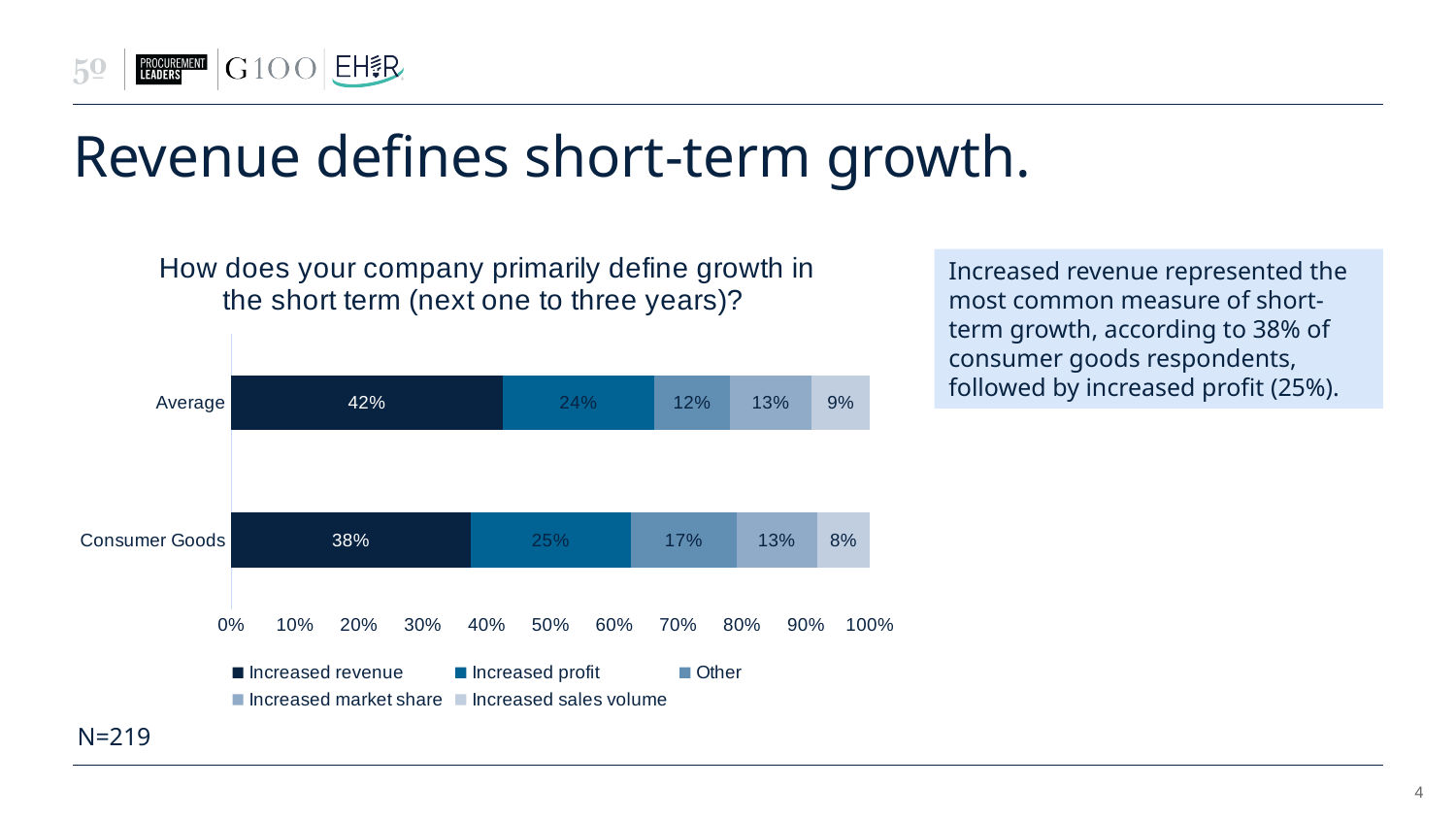
How many series does the legend list? 5 By how many percentage points does the Increased revenue share for Average exceed that for Consumer Goods? 4 percentage points Which category has the larger Increased revenue share, Average or Consumer Goods? Average Which series makes up the largest segment of the Consumer Goods bar? Increased revenue What type of chart is shown on the slide? Stacked bar chart What is the title of the chart? How does your company primarily define growth in the short term (next one to three years)? By how many percentage points does the Increased profit share for Consumer Goods exceed that for Average? 1 percentage point What percentage of the Consumer Goods bar is Increased revenue? 38% What percentage of the Average bar is Increased revenue? 42% How many categories (bars) are shown in the chart? 2 What is the Increased profit value for Average? 24% What is the Increased profit value for Consumer Goods? 25%